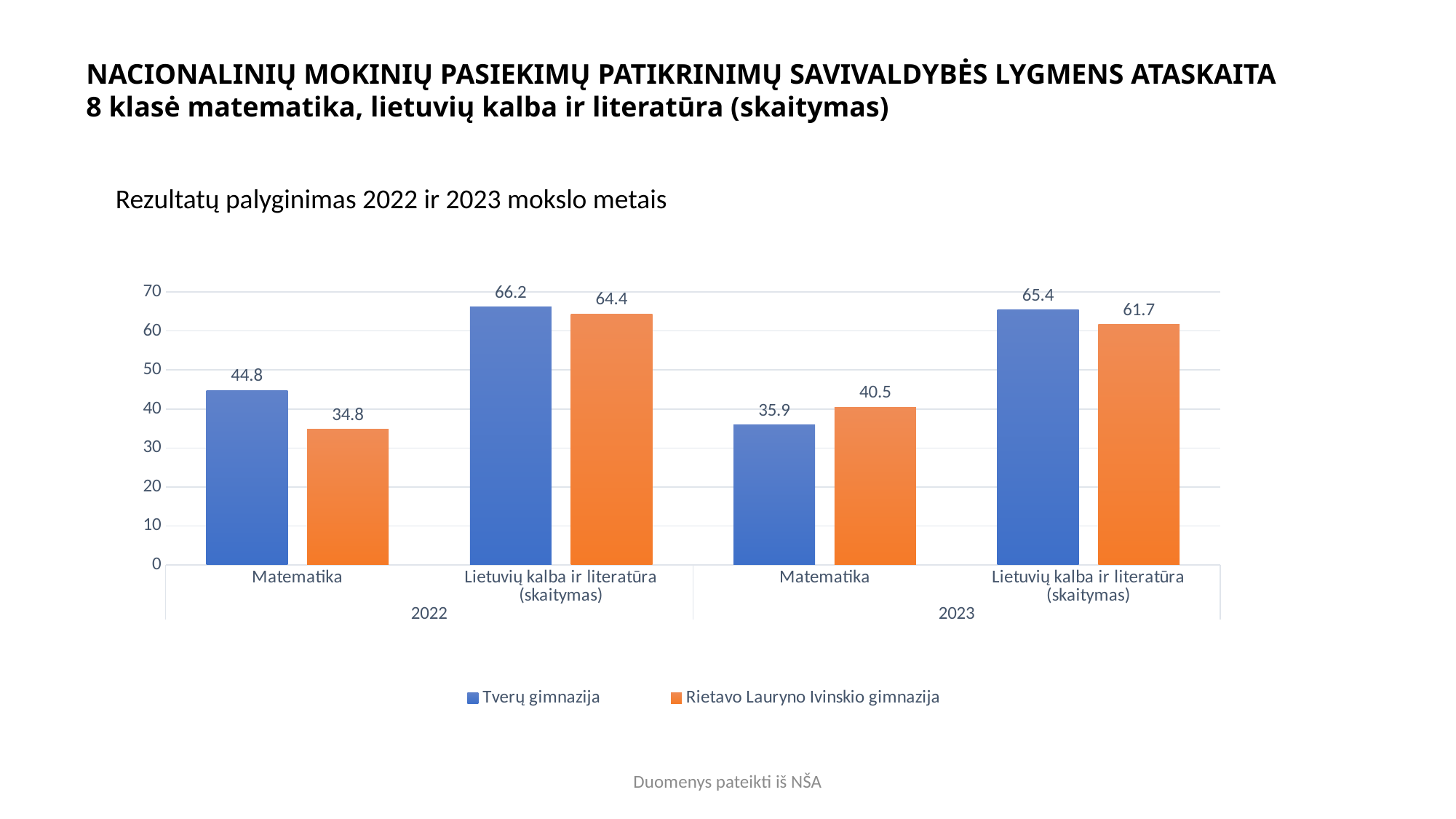
How many category groups are shown on the x axis? 4 What is the value for Rietavo Lauryno Ivinskio gimnazija in Matematika in 2023? 40.5 What is the value for Tverų gimnazija in Lietuvių kalba ir literatūra (skaitymas) in 2023? 65.4 What is the difference between Tverų gimnazija and Rietavo Lauryno Ivinskio gimnazija in Matematika in 2022? 10 Which bar has the lowest value in the chart? Rietavo Lauryno Ivinskio gimnazija, Matematika 2022 Which bar has the highest value in the chart? Tverų gimnazija, Lietuvių kalba ir literatūra (skaitymas) 2022 What is the value for Rietavo Lauryno Ivinskio gimnazija in Lietuvių kalba ir literatūra (skaitymas) in 2022? 64.4 What is the value for Tverų gimnazija in Matematika in 2022? 44.8 Which school has the larger value in Matematika in 2023? Rietavo Lauryno Ivinskio gimnazija How many series does the legend list? 2 What kind of chart is shown on the slide? bar chart What is the difference between Tverų gimnazija and Rietavo Lauryno Ivinskio gimnazija in Lietuvių kalba ir literatūra (skaitymas) in 2023? 3.7